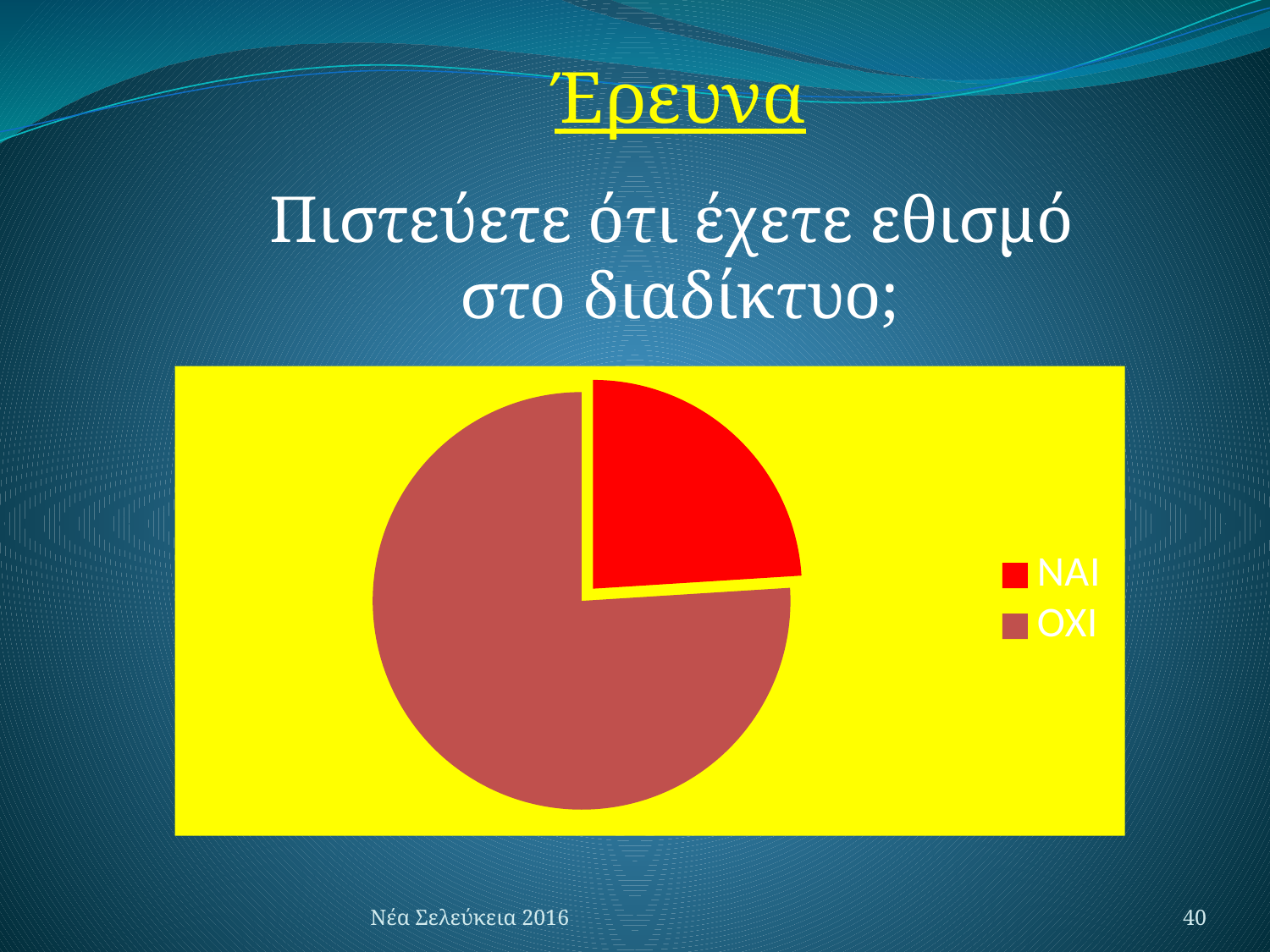
Which category has the smallest slice in the pie chart? ΝΑΙ What are the two legend entries of the pie chart? ΝΑΙ and ΟΧΙ Which slice is larger in the pie chart, ΝΑΙ or ΟΧΙ? ΟΧΙ What kind of chart is shown on the slide? pie chart How many entries does the legend of the pie chart list? 2 What colour is the ΝΑΙ slice in the pie chart? red How many slices does the pie chart have? 2 Which category has the largest slice in the pie chart? ΟΧΙ